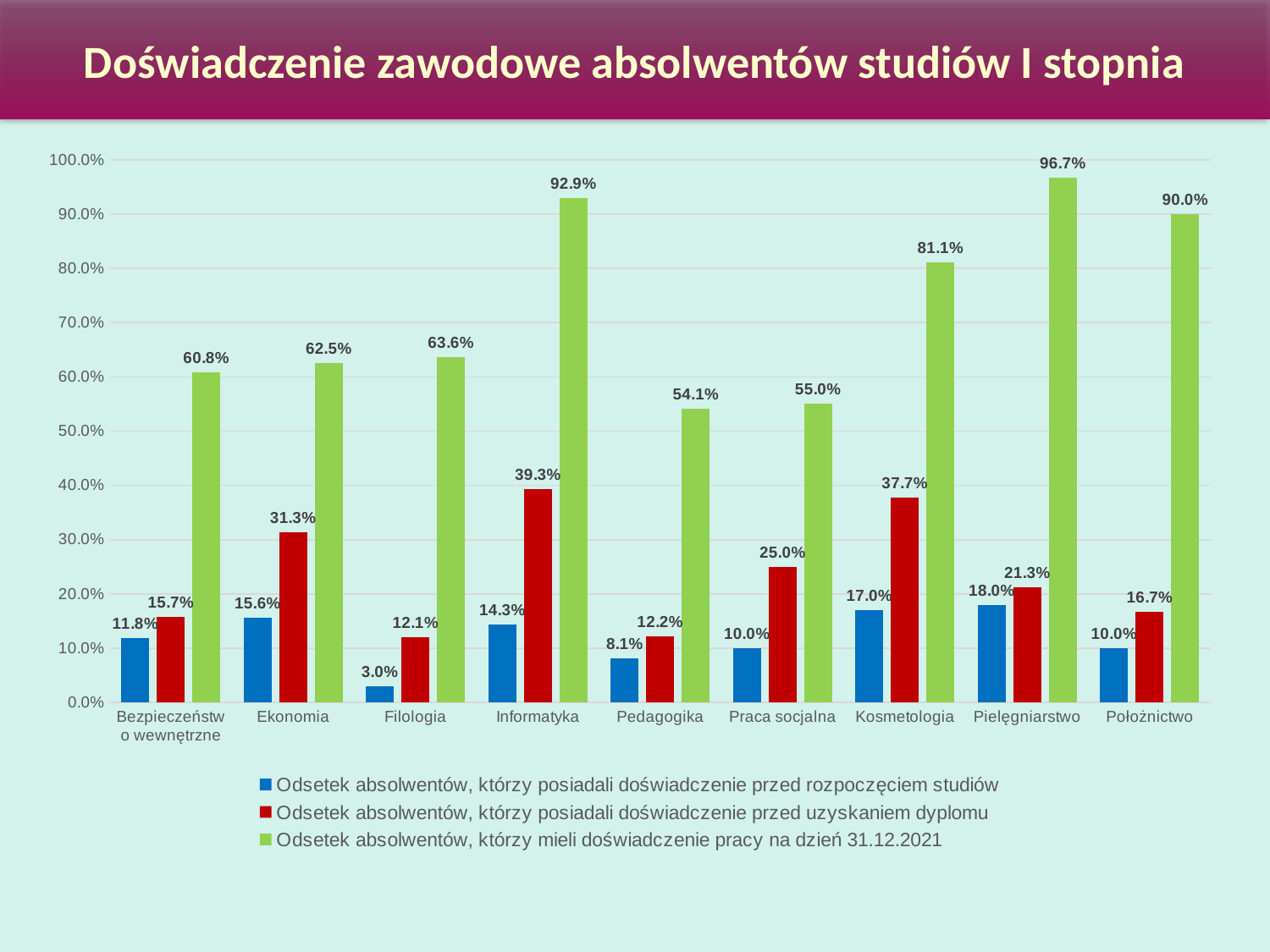
Which field of study has the lowest value in the series 'Odsetek absolwentów, którzy posiadali doświadczenie przed rozpoczęciem studiów'? Filologia What colour are the bars for the series 'Odsetek absolwentów, którzy posiadali doświadczenie przed uzyskaniem dyplomu'? Red Which is larger for Ekonomia: the value for 'przed rozpoczęciem studiów' or the value for 'przed uzyskaniem dyplomu'? przed uzyskaniem dyplomu What is the difference between the 'na dzień 31.12.2021' value and the 'przed uzyskaniem dyplomu' value for Informatyka? 53.6% What is the value for Kosmetologia in the series 'Odsetek absolwentów, którzy posiadali doświadczenie przed uzyskaniem dyplomu'? 37.7% What is the value for Informatyka in the series 'Odsetek absolwentów, którzy mieli doświadczenie pracy na dzień 31.12.2021'? 92.9% What is the value for Filologia in the series 'Odsetek absolwentów, którzy posiadali doświadczenie przed rozpoczęciem studiów'? 3.0% Which field of study has the highest value in the series 'Odsetek absolwentów, którzy mieli doświadczenie pracy na dzień 31.12.2021'? Pielęgniarstwo Is the value for Pedagogika in the series 'Odsetek absolwentów, którzy mieli doświadczenie pracy na dzień 31.12.2021' greater or less than 60.0%? less How many series does the legend list? 3 What type of chart is shown on the slide? Bar chart How many fields of study (categories) are shown on the x axis? 9